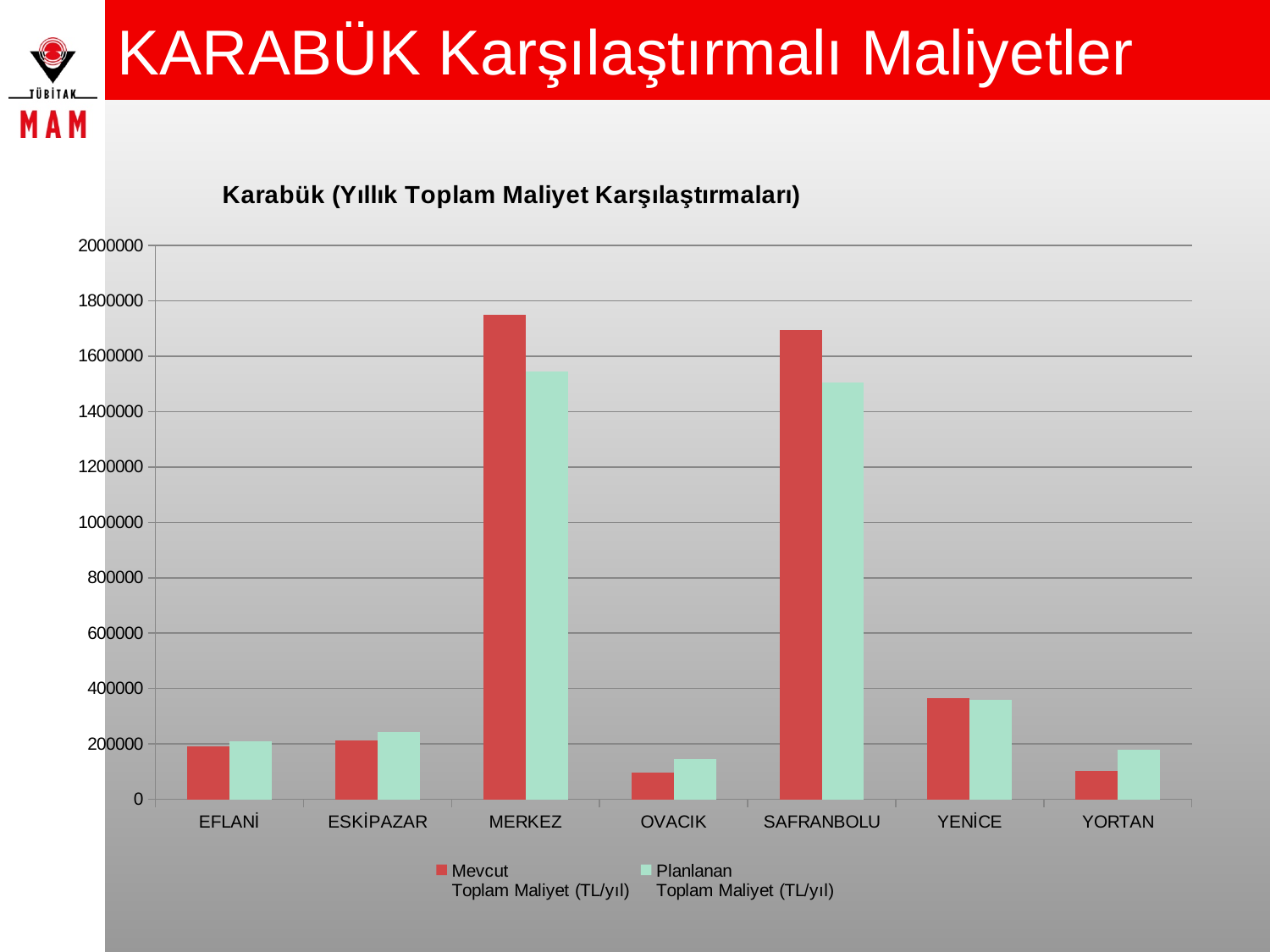
How many series does the legend list? 2 What is the title of the chart? Karabük (Yıllık Toplam Maliyet Karşılaştırmaları) How many categories (districts) are shown on the x axis? 7 Is the Mevcut Toplam Maliyet value for MERKEZ greater or less than 1600000? greater Is the Planlanan Toplam Maliyet value for ESKİPAZAR greater or less than 200000? greater For MERKEZ, which is larger: Mevcut Toplam Maliyet or Planlanan Toplam Maliyet? Mevcut Toplam Maliyet Which category has the highest Mevcut Toplam Maliyet (TL/yıl) value? MERKEZ Is the Planlanan Toplam Maliyet value for SAFRANBOLU greater or less than 1600000? less What kind of chart is shown on the slide? bar chart Which category has the lowest Planlanan Toplam Maliyet (TL/yıl) value? OVACIK For YORTAN, which is larger: Mevcut Toplam Maliyet or Planlanan Toplam Maliyet? Planlanan Toplam Maliyet